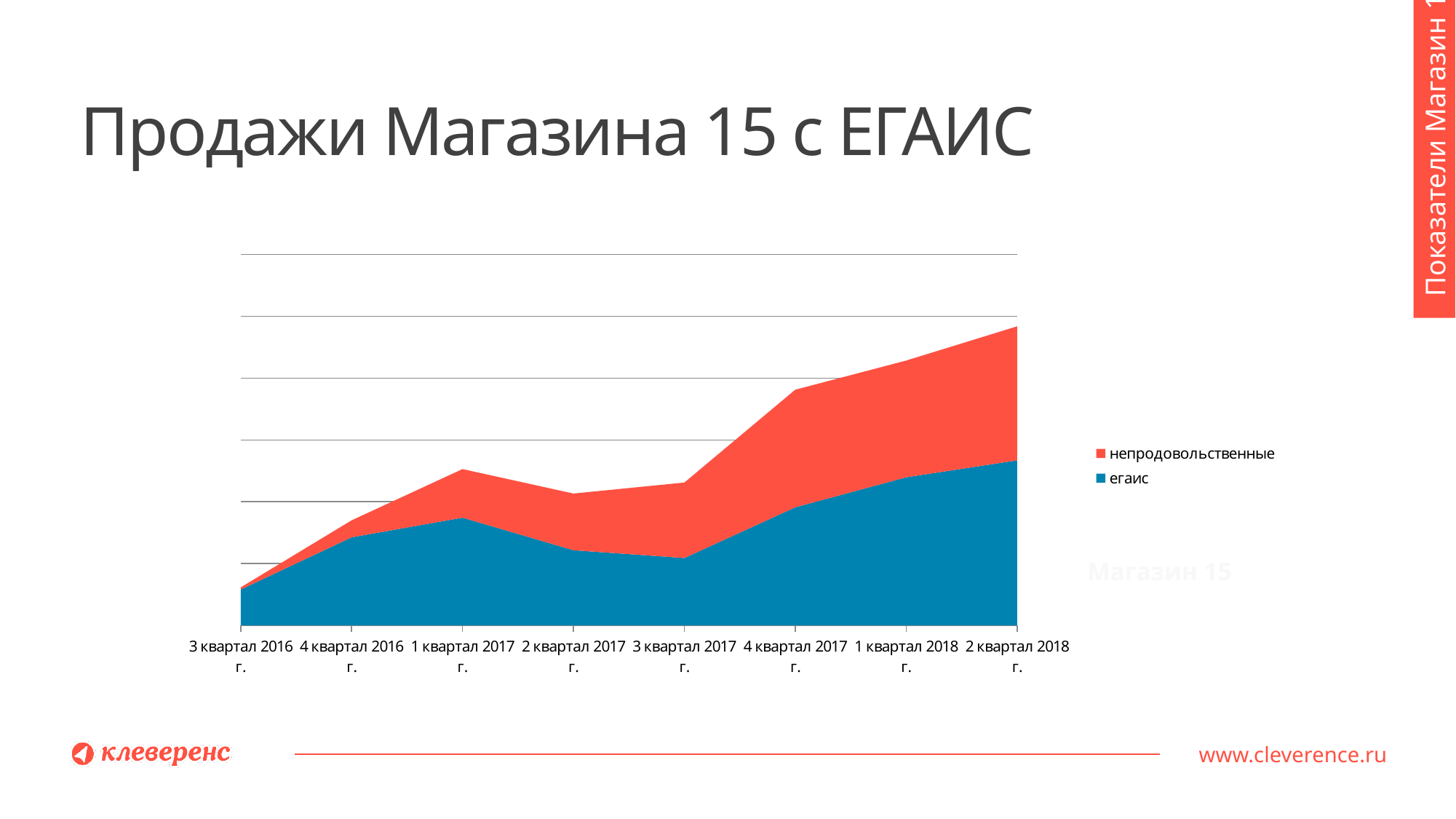
Does the total stacked value generally rise or fall from 3 квартал 2016 г. to 2 квартал 2018 г.? Rise What kind of chart is shown on the slide? Stacked area chart In which quarter is the total stacked value lowest? 3 квартал 2016 г. Is the total stacked value higher in 4 квартал 2017 г. or in 1 квартал 2017 г.? 4 квартал 2017 г. In which quarter is the егаис series at its highest? 2 квартал 2018 г. How many series does the chart legend list? 2 Which series is shown in blue in the chart? егаис In which quarter is the егаис series at its lowest? 3 квартал 2016 г. Is the егаис value higher in 1 квартал 2017 г. or in 3 квартал 2017 г.? 1 квартал 2017 г. In which quarter is the total stacked value highest? 2 квартал 2018 г. What is the title of the slide containing the chart? Продажи Магазина 15 с ЕГАИС How many quarters are plotted along the x axis of the chart? 8